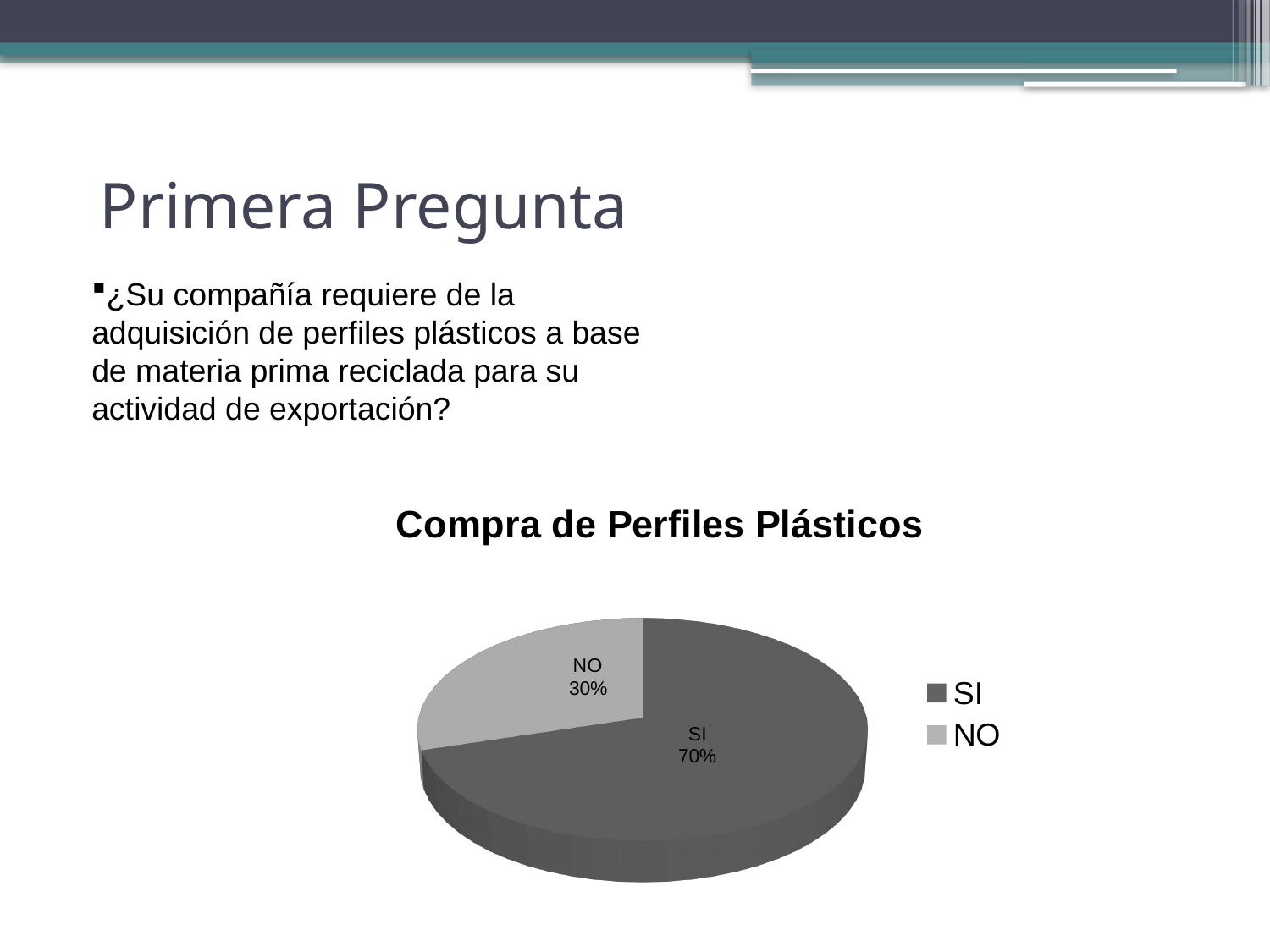
What kind of chart is shown on the slide? Pie chart What share of the pie does the NO slice represent? 30% How many entries does the legend list? 2 How many slices does the pie chart have? 2 What share of the pie does the SI slice represent? 70% Which slice is larger, SI or NO? SI Which legend entry is shown in the lighter grey colour? NO Which slice is the smallest in the pie chart? NO What is the difference in percentage points between the SI and NO slices? 40 Which slice is the largest in the pie chart? SI What is the title of the chart? Compra de Perfiles Plásticos